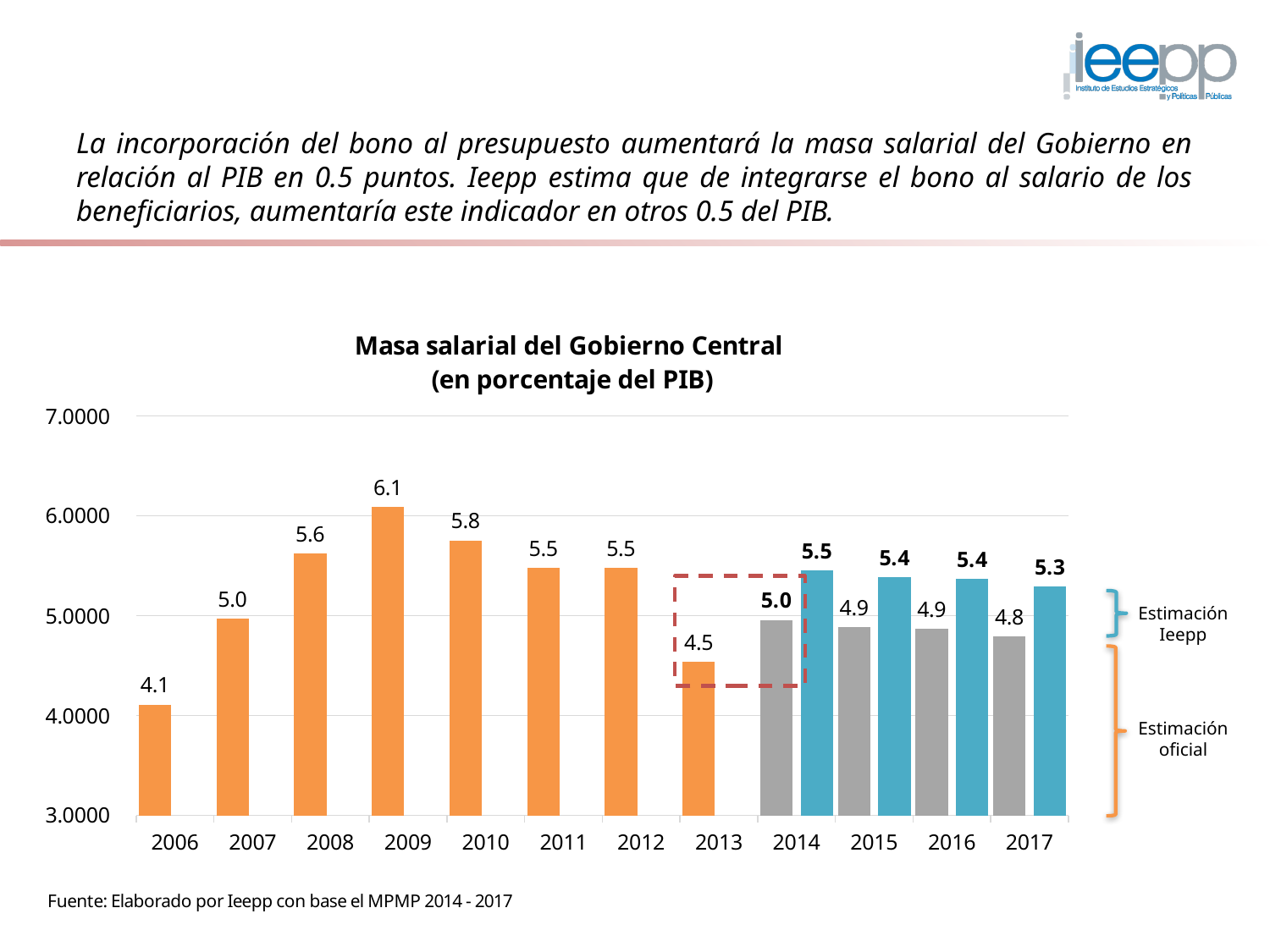
What is the official estimate (Estimación oficial) for 2017? 4.8 What is the Ieepp estimate (Estimación Ieepp) for 2014? 5.5 Which year has the highest value in the chart? 2009 What kind of chart is shown on the slide? Bar chart Which is larger, the value for 2010 or the value for 2013? 2010 What is the difference between the values for 2009 and 2013? 1.6 How many years are shown on the x axis of the chart? 12 What is the difference between the Ieepp estimate and the official estimate for 2015? 0.5 What is the value for 2009 in the chart? 6.1 Which year has the lowest value in the chart? 2006 What is the title of the chart? Masa salarial del Gobierno Central (en porcentaje del PIB) What is the value for 2006 in the chart? 4.1